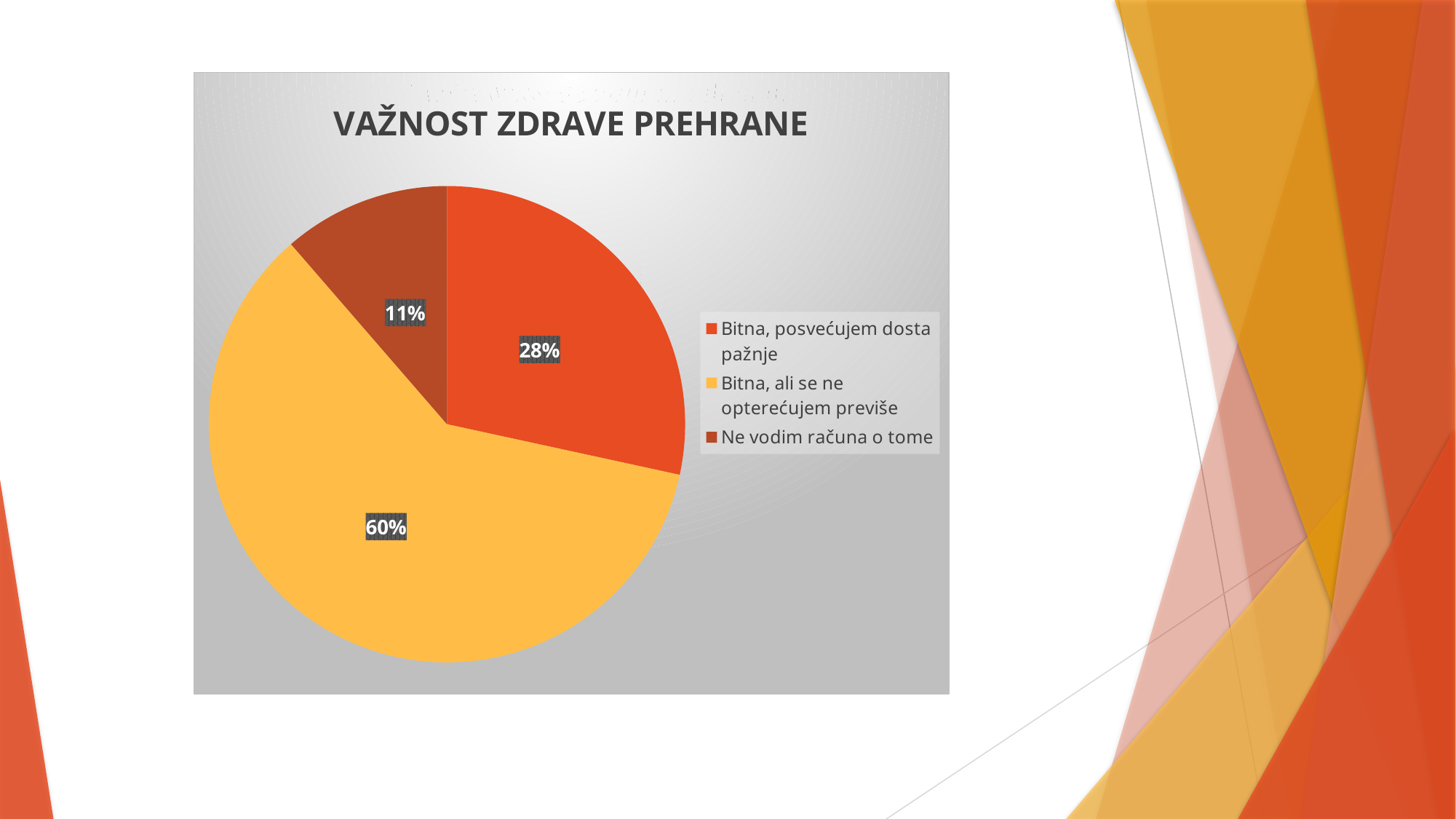
What share of the pie does "Bitna, ali se ne opterećujem previše" represent? 60% What share of the pie does "Bitna, posvećujem dosta pažnje" represent? 28% Which category has the smallest slice of the pie? Ne vodim računa o tome What kind of chart is shown on the slide? Pie chart Which category has the largest slice of the pie? Bitna, ali se ne opterećujem previše Which is larger: the slice for "Bitna, posvećujem dosta pažnje" or the slice for "Ne vodim računa o tome"? Bitna, posvećujem dosta pažnje How many categories are shown in the pie chart? 3 What is the difference in percentage points between "Bitna, ali se ne opterećujem previše" and "Bitna, posvećujem dosta pažnje"? 32 What share of the pie does "Ne vodim računa o tome" represent? 11% What colour is the slice for "Ne vodim računa o tome"? Dark brown-red What is the title of the chart? VAŽNOST ZDRAVE PREHRANE What is the difference in percentage points between "Bitna, posvećujem dosta pažnje" and "Ne vodim računa o tome"? 17